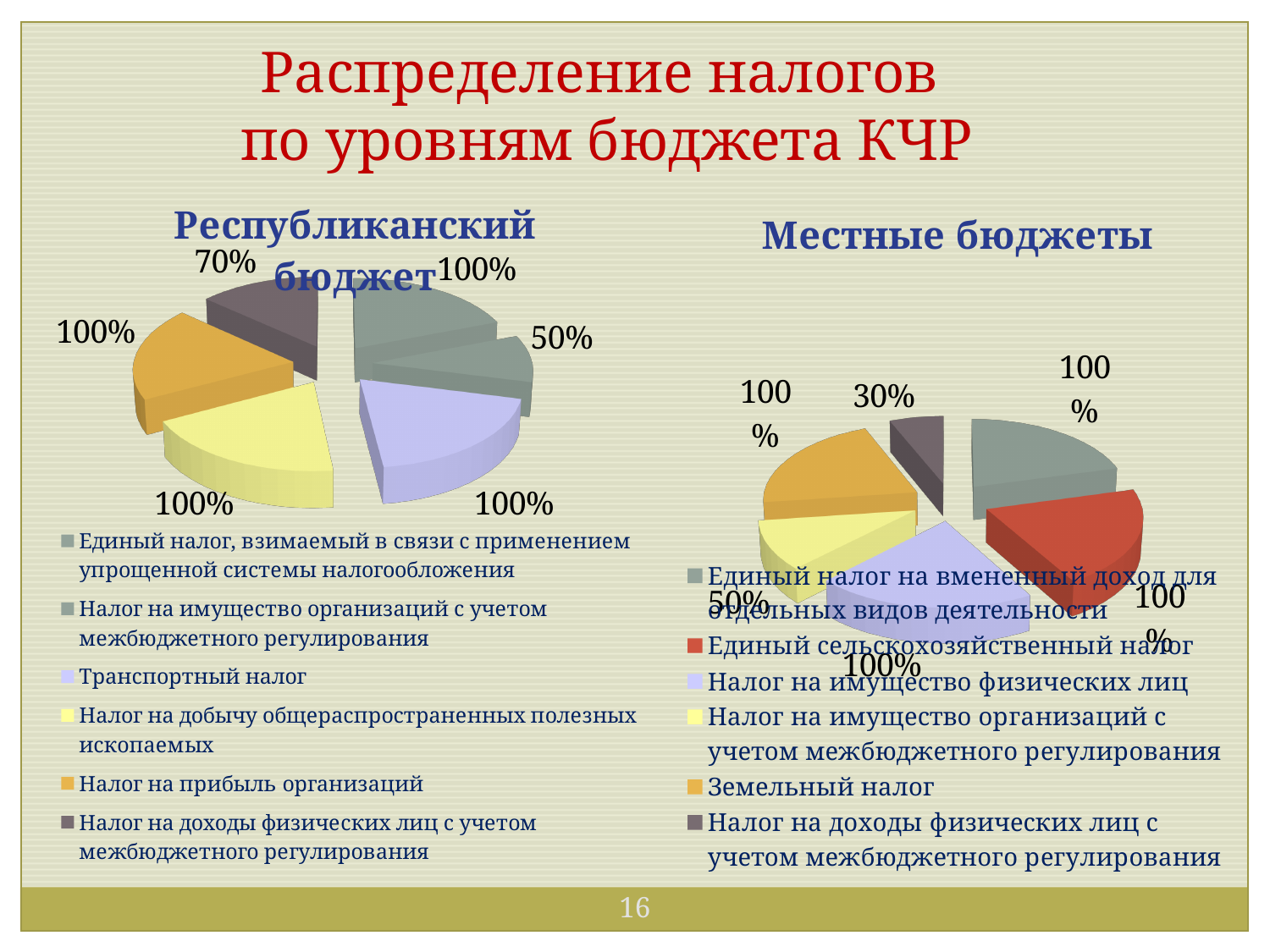
In the "Местные бюджеты" chart, what value is shown for "Земельный налог"? 100% What type of chart is used for the "Республиканский бюджет" chart? pie chart In the "Местные бюджеты" chart, what value is shown for "Налог на имущество организаций с учетом межбюджетного регулирования"? 50% In the "Местные бюджеты" chart, which is larger: the value for "Единый сельскохозяйственный налог" or the value for "Налог на доходы физических лиц с учетом межбюджетного регулирования"? Единый сельскохозяйственный налог Which category has the lowest value in the "Республиканский бюджет" chart? Налог на имущество организаций с учетом межбюджетного регулирования How many slices does the "Местные бюджеты" pie chart have? 6 In the "Республиканский бюджет" chart, what value is shown for "Налог на доходы физических лиц с учетом межбюджетного регулирования"? 70% Which category has the lowest value in the "Местные бюджеты" chart? Налог на доходы физических лиц с учетом межбюджетного регулирования In the "Республиканский бюджет" chart, what value is shown for "Налог на имущество организаций с учетом межбюджетного регулирования"? 50% How many entries does the legend of the "Республиканский бюджет" chart list? 6 In the "Республиканский бюджет" chart, what is the difference between the value for "Транспортный налог" and the value for "Налог на доходы физических лиц с учетом межбюджетного регулирования"? 30% In the "Местные бюджеты" chart, what value is shown for "Налог на доходы физических лиц с учетом межбюджетного регулирования"? 30%